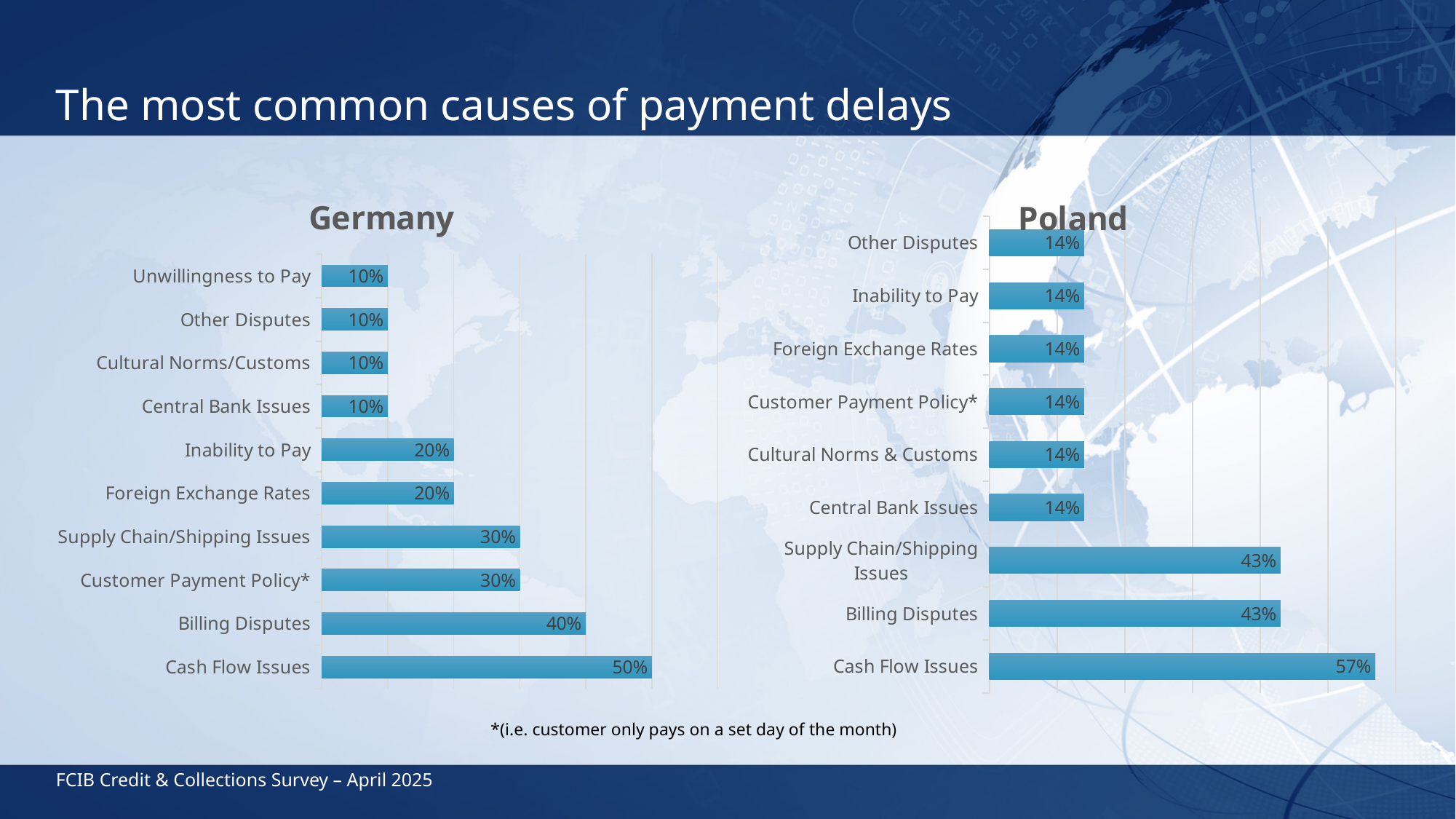
How many categories does the Poland chart show? 9 How many categories does the Germany chart show? 10 In the Germany chart, what is the value for Billing Disputes? 40% In the Poland chart, what is the difference between Cash Flow Issues and Billing Disputes? 14% In the Germany chart, what is the value for Cash Flow Issues? 50% In the Poland chart, what is the value for Supply Chain/Shipping Issues? 43% In the Germany chart, which category has the highest value? Cash Flow Issues In the Germany chart, which is larger: Supply Chain/Shipping Issues or Inability to Pay? Supply Chain/Shipping Issues In the Poland chart, what is the value for Central Bank Issues? 14% In the Germany chart, what is the difference between Cash Flow Issues and Billing Disputes? 10% In the Poland chart, which category has the highest value? Cash Flow Issues What type of chart is the Poland chart? Bar chart